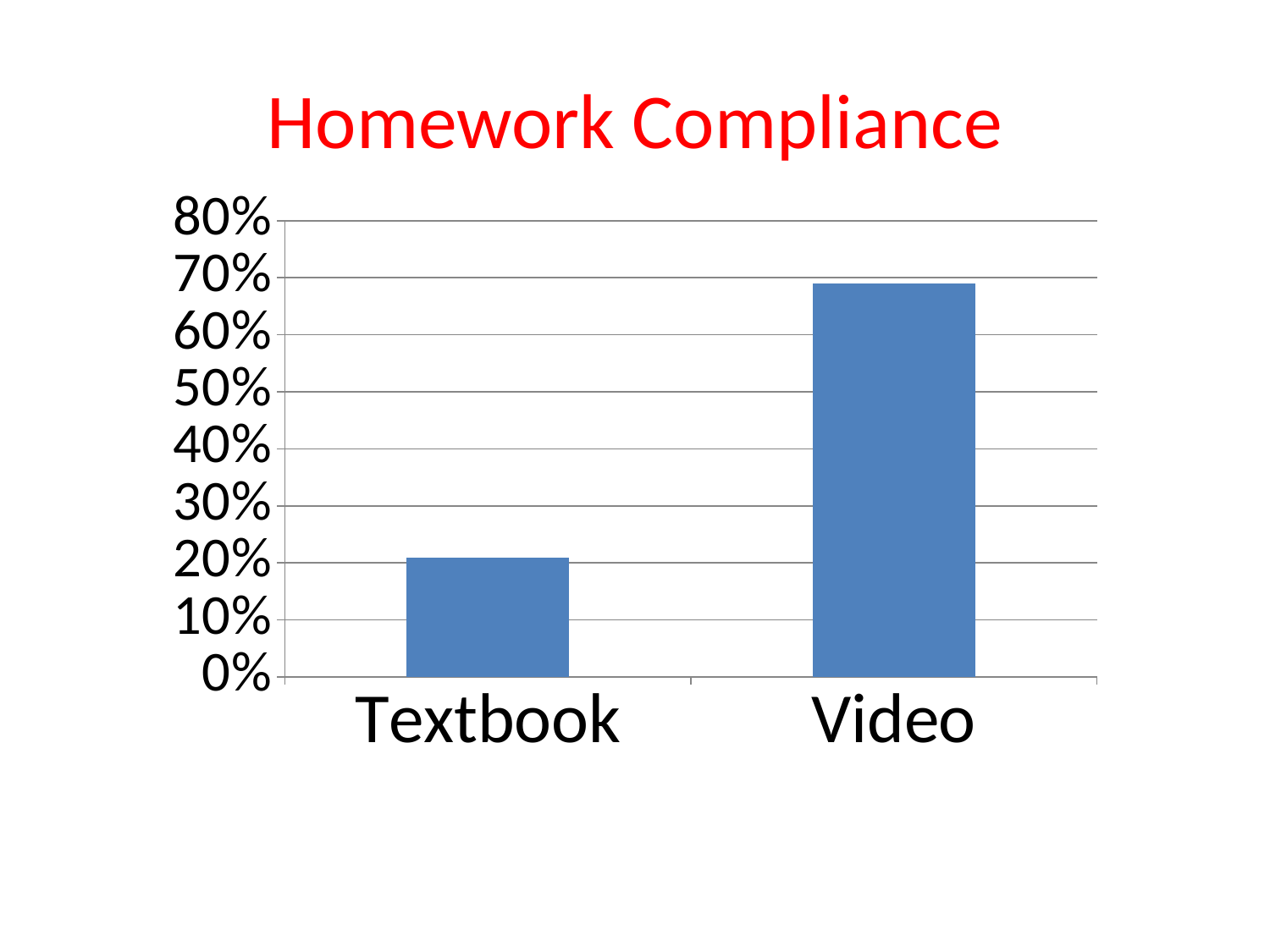
Is the value for Video greater or less than 50%? greater What is the title of the chart? Homework Compliance Is the value for Textbook greater or less than 40%? less How many categories are shown on the x axis of the chart? 2 Which has a larger value, Textbook or Video? Video Is the value for Textbook greater or less than 30%? less Do the values rise or fall from Textbook to Video along the x axis? rise Which category has the highest value in the chart? Video Which category has the lowest value in the chart? Textbook What is the highest value shown on the y axis of the chart? 80% What type of chart is shown on the slide? bar chart